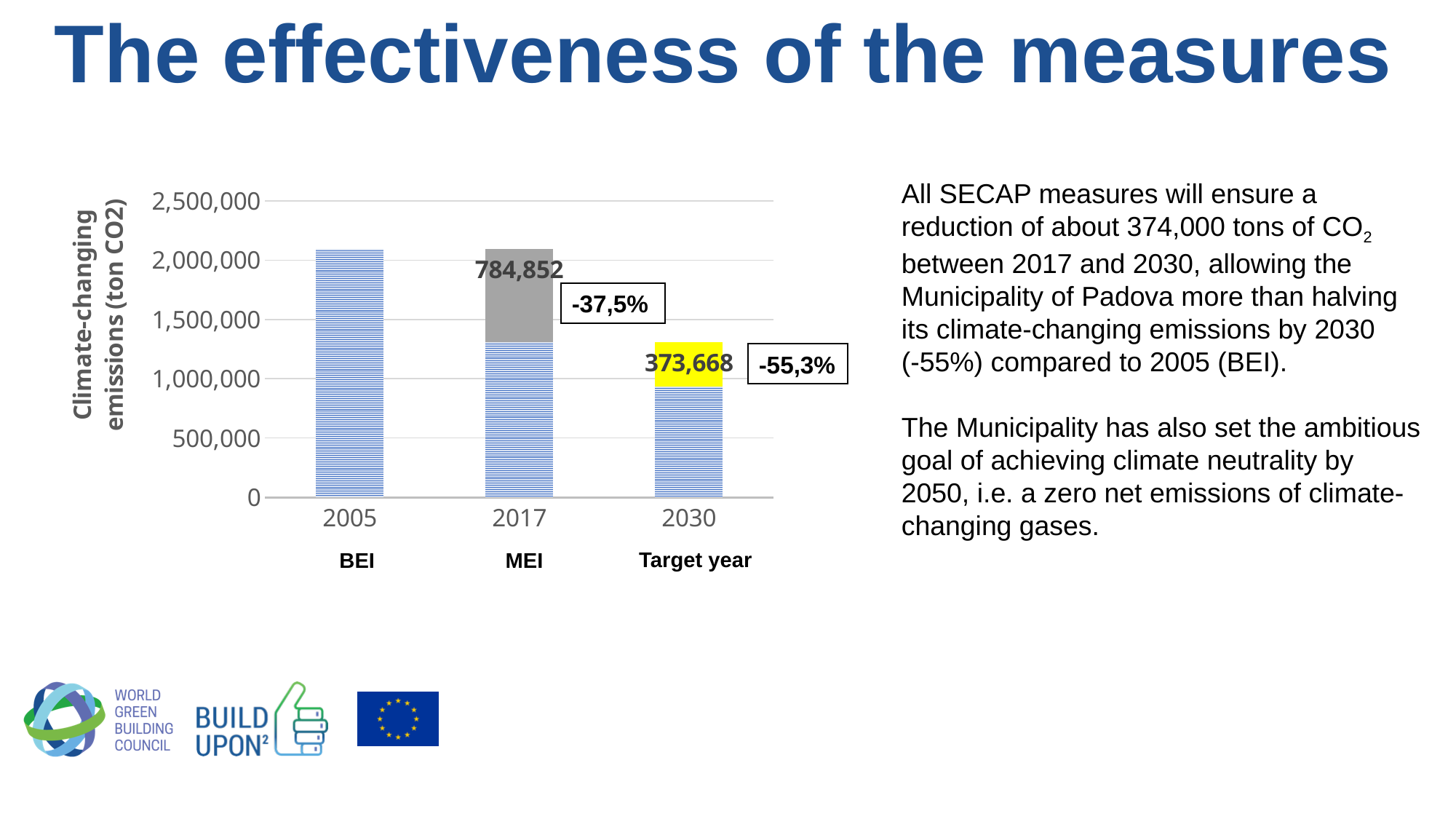
What value is printed on the yellow segment of the 2030 bar? 373,668 Which year has the tallest bar? 2005 How many bars (years) are plotted in the chart? 3 Which is larger, the labelled grey segment of the 2017 bar or the labelled yellow segment of the 2030 bar? the grey segment of the 2017 bar (784,852) What value is printed on the grey segment of the 2017 bar? 784,852 What is the difference between the labelled segment values 784,852 (2017) and 373,668 (2030)? 411,184 What kind of chart is shown on the slide? bar chart What percentage is shown in the box next to the 2030 bar? -55,3% Do the bar heights rise or fall from 2005 to 2030? fall Which year has the shortest bar? 2030 Is the total height of the 2005 bar greater or less than 1,500,000? greater Is the total height of the 2030 bar greater or less than 1,500,000? less